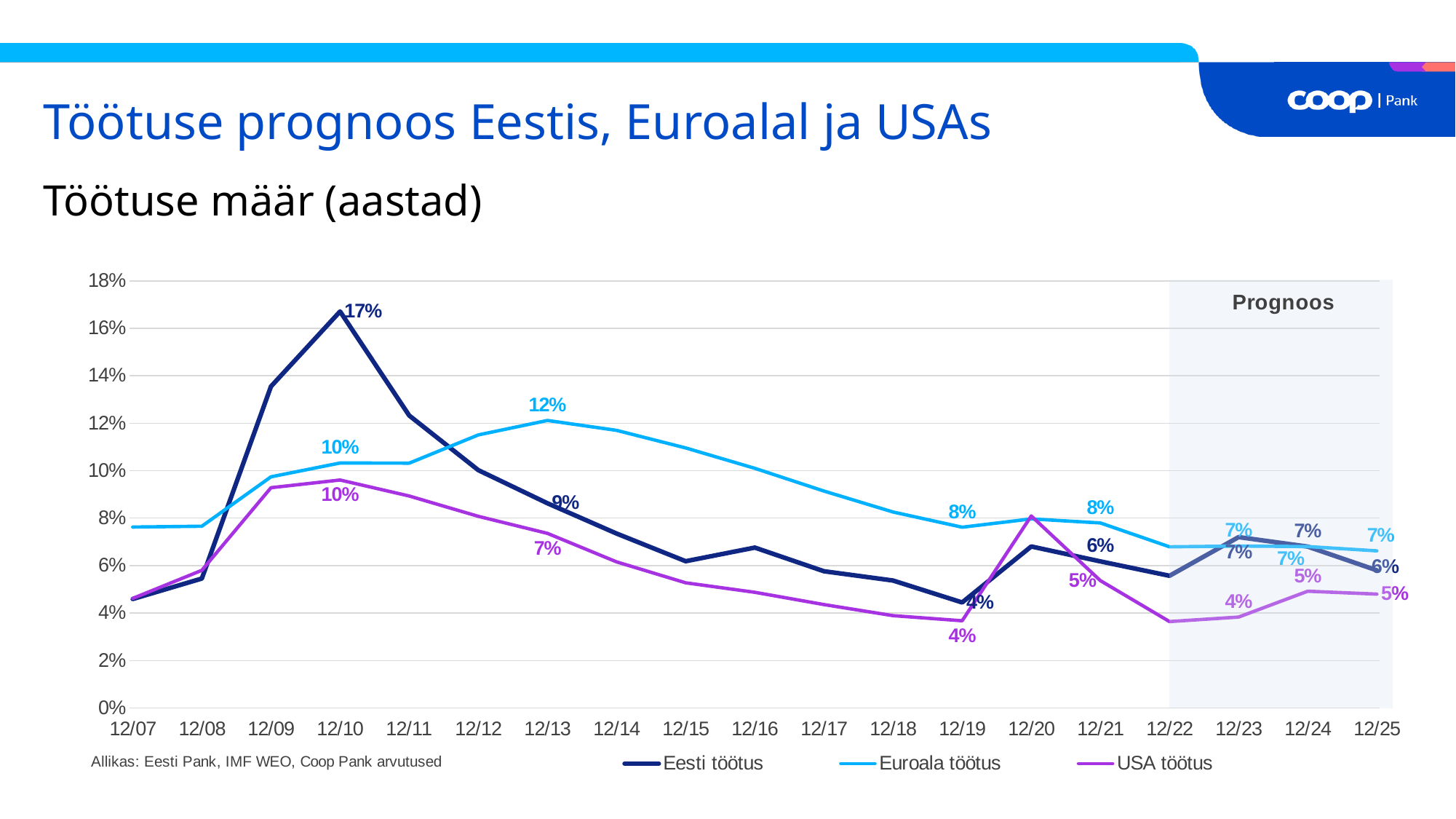
At 12/13, which is larger: Euroala töötus or Eesti töötus? Euroala töötus How many series does the legend list? 3 At which time point does Eesti töötus reach its highest value? 12/10 What kind of chart is shown on the slide? line chart What is the difference between Eesti töötus and Euroala töötus at 12/10? 7 percentage points What is the value of USA töötus at 12/25? 5% Does Euroala töötus rise or fall from 12/13 to 12/19? fall Is the value for Eesti töötus at 12/09 greater or less than 12%? greater How many time points are shown on the x axis? 19 What is the value of Eesti töötus at 12/10? 17% What is the value of Euroala töötus at 12/13? 12% What is the value of USA töötus at 12/19? 4%